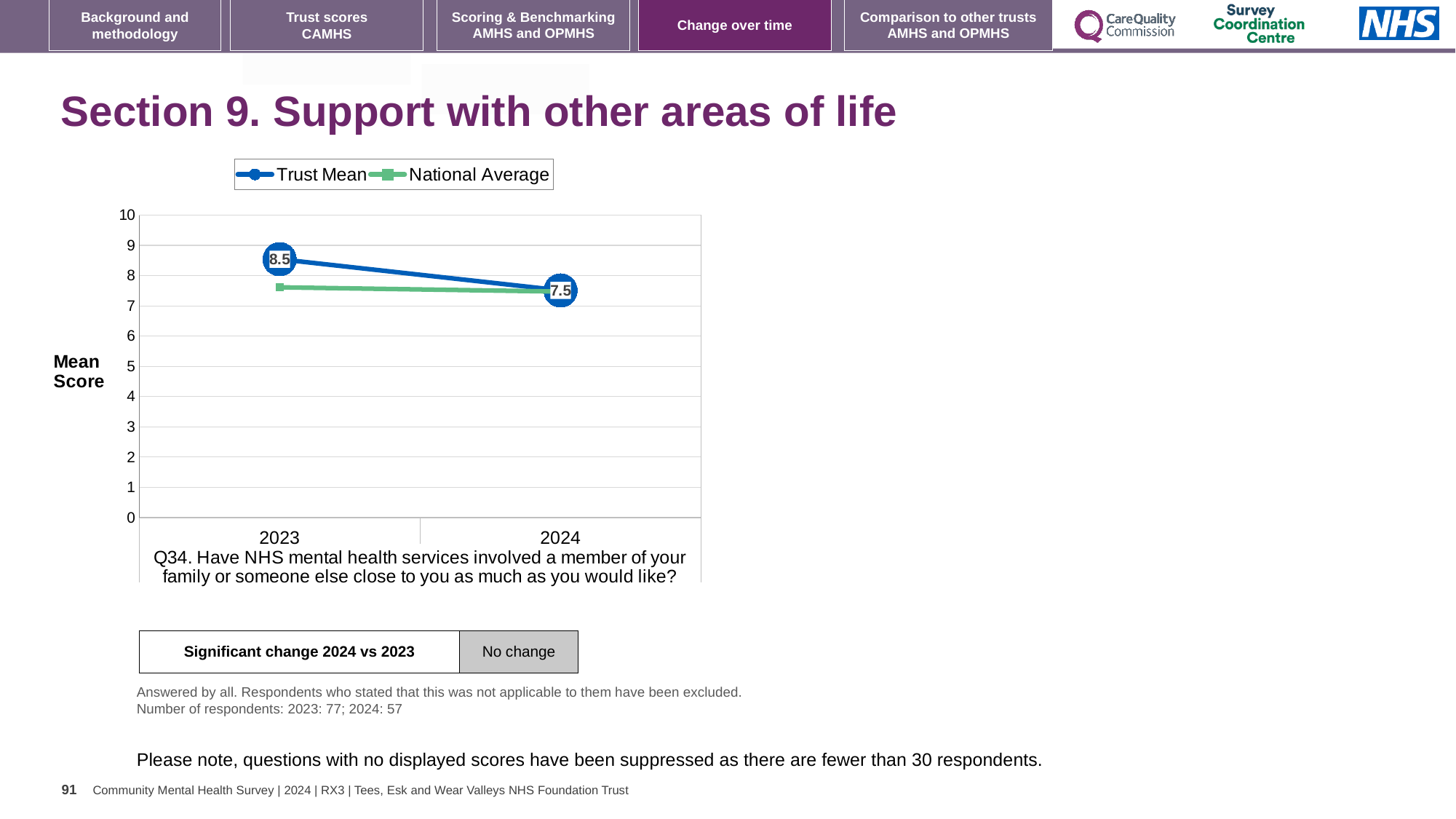
What is the Trust Mean score for 2023? 8.5 Does the Trust Mean rise or fall from 2023 to 2024? fall How many years are plotted on the x axis? 2 What kind of chart is shown on the slide? line chart Is the National Average value for 2023 greater or less than 5? greater What is the label on the y axis of the chart? Mean Score How many series does the legend list? 2 What is the Trust Mean score for 2024? 7.5 In 2023, which is higher: the Trust Mean or the National Average? Trust Mean In which year is the Trust Mean highest? 2023 In which year is the Trust Mean lowest? 2024 By how much did the Trust Mean score change from 2023 to 2024? 1.0